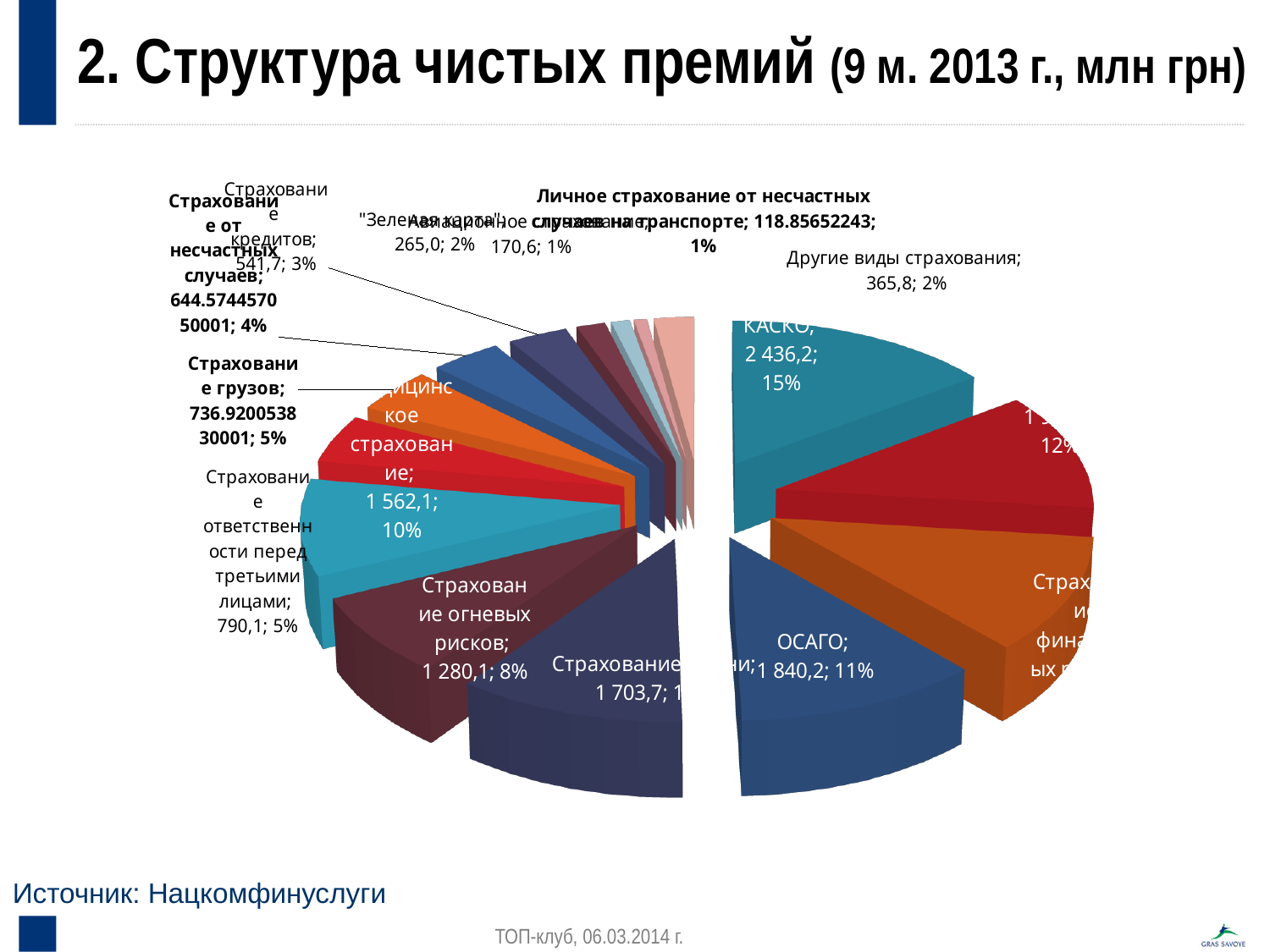
What is the difference between the values for КАСКО and ОСАГО? 596,0 What is the value for Другие виды страхования? 365,8 What is the value for "Зеленая карта"? 265,0 Which is larger, КАСКО or ОСАГО? КАСКО Which category has the largest slice of the pie? КАСКО What is the value for Страхование ответственности перед третьими лицами? 790,1 What kind of chart is shown on the slide? pie chart What is the value for ОСАГО? 1 840,2 What is the value for Страхование огневых рисков? 1 280,1 What is the value for КАСКО? 2 436,2 What share of the pie does КАСКО represent? 15% What share of the pie does Страхование огневых рисков represent? 8%